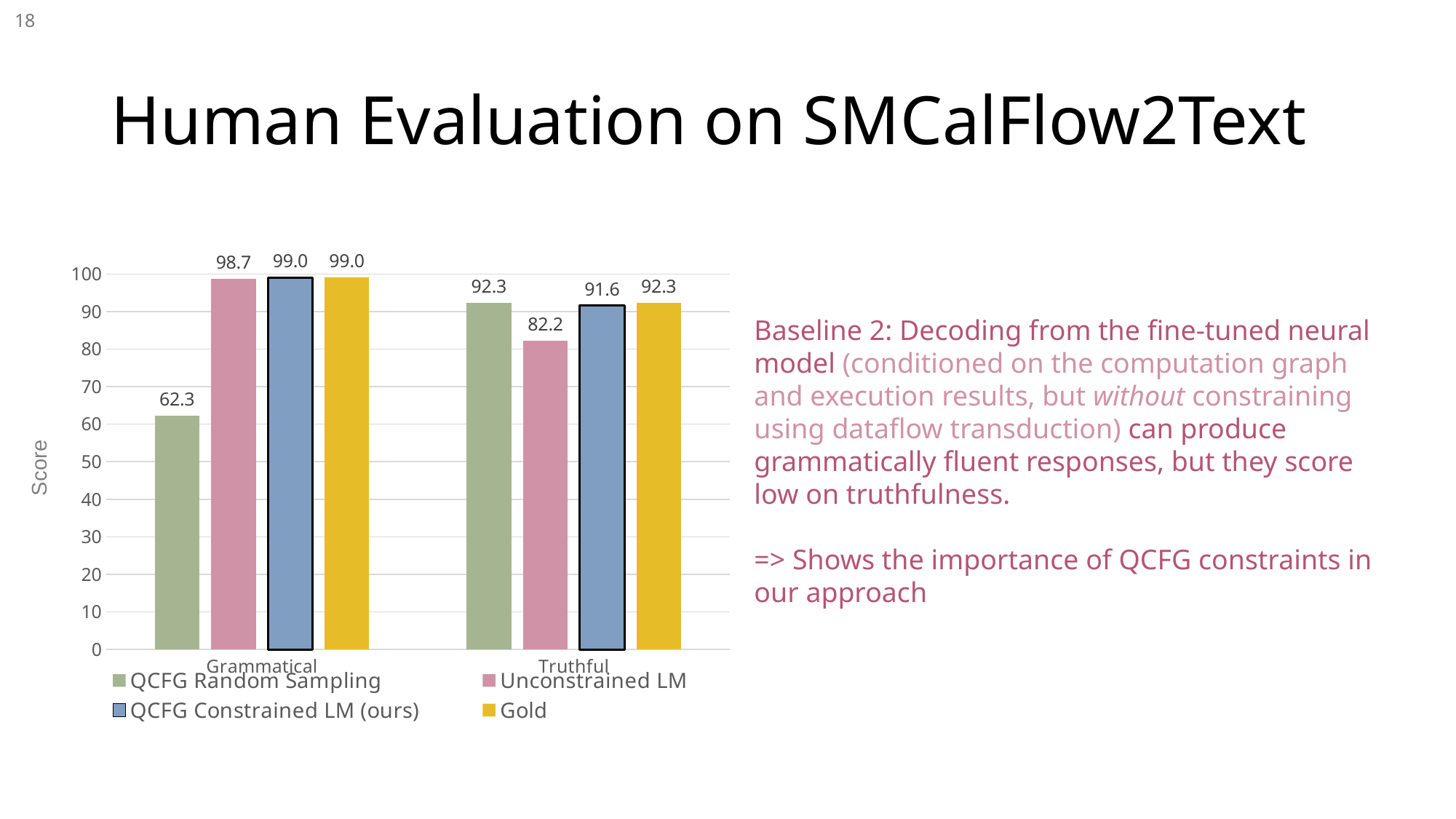
What is the label of the y axis? Score Which series has the lowest Grammatical score? QCFG Random Sampling How many categories are shown on the x axis? 2 What is the Grammatical score for Gold? 99.0 What kind of chart is shown on the slide? Bar chart Which is larger: the Truthful score for QCFG Random Sampling or for Unconstrained LM? QCFG Random Sampling What is the difference between the Grammatical and Truthful scores for Unconstrained LM? 16.5 What is the Grammatical score for QCFG Random Sampling? 62.3 Which series has the lowest Truthful score? Unconstrained LM What is the Truthful score for Unconstrained LM? 82.2 How many series does the legend list? 4 What is the Truthful score for QCFG Constrained LM (ours)? 91.6